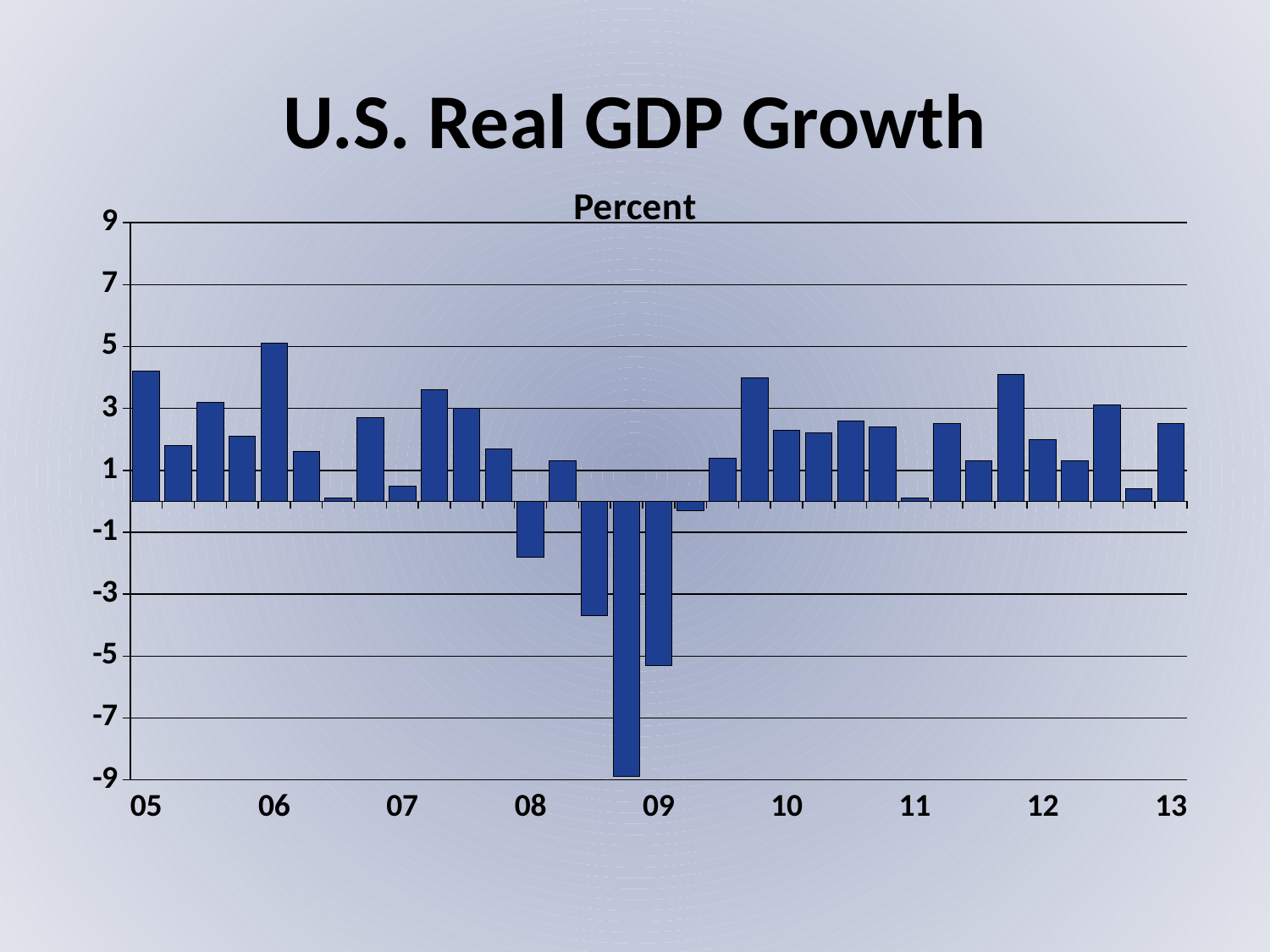
Is the value for the bar at 06 greater or less than 4? greater Is the value for the bar at 07 greater or less than 1? less Is the value for the bar at 09 greater or less than -3? less How many bars on the chart have negative values? 5 How many year labels are shown on the x axis? 9 Which bar is larger, the one at 05 or the one at 07? 05 What is the title of the chart? U.S. Real GDP Growth What kind of chart is shown on the slide? bar chart Which bar is larger, the one at 08 or the one at 09? 08 What unit label is shown above the chart's vertical axis? Percent